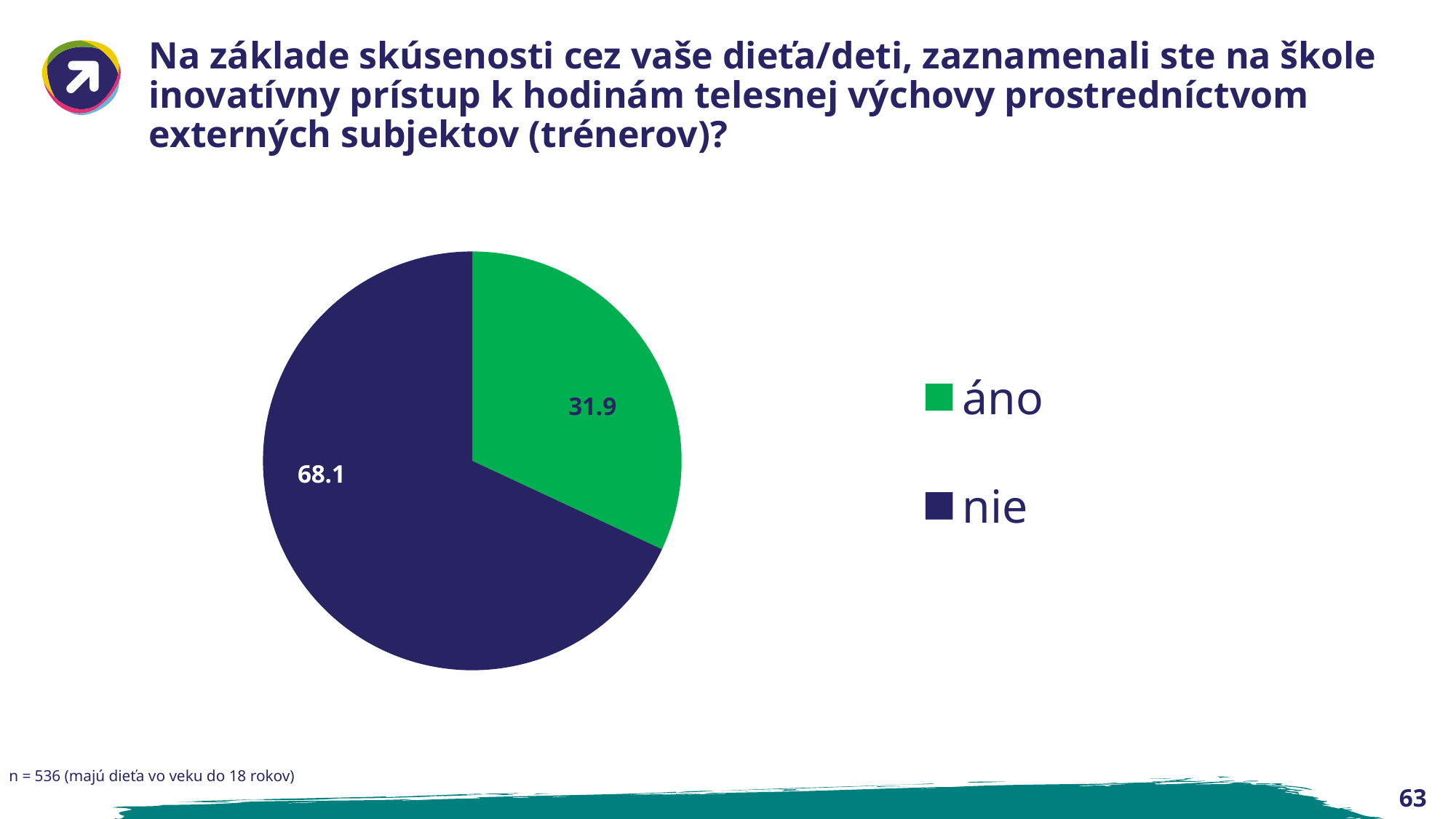
What value is shown for the "áno" slice of the pie chart? 31.9 What sample size (n) is stated below the pie chart? n = 536 How many entries does the legend of the pie chart list? 2 Which colour represents "áno" in the pie chart? green Which slice of the pie chart is the largest? nie Which slice of the pie chart is the smallest? áno How many slices does the pie chart have? 2 What kind of chart is shown on the slide? pie chart What is the difference between the "nie" and "áno" values in the pie chart? 36.2 Which is larger in the pie chart, "áno" or "nie"? nie What is the total of the two values shown in the pie chart? 100 What value is shown for the "nie" slice of the pie chart? 68.1